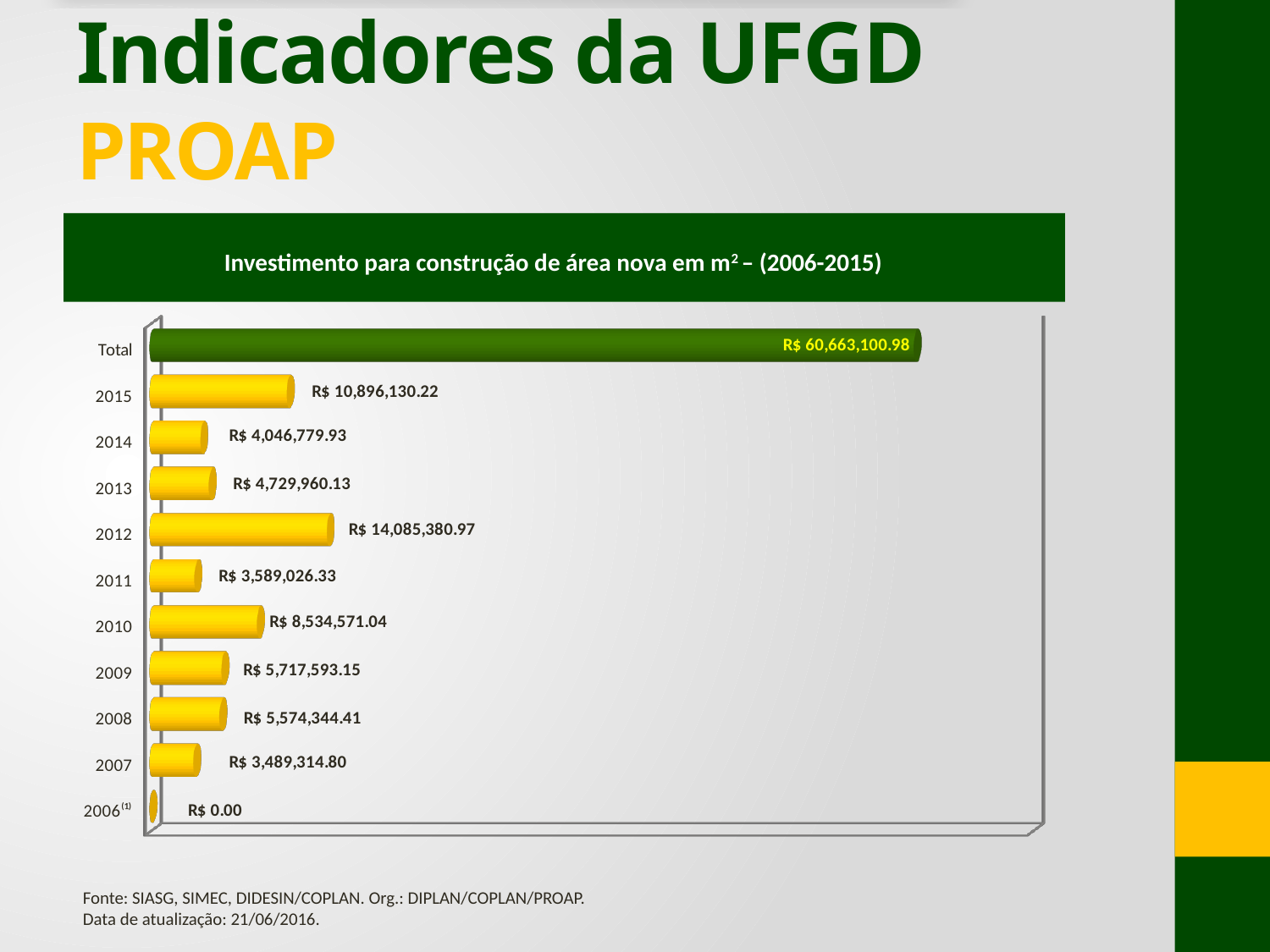
What is the title of the chart? Investimento para construção de área nova em m² – (2006-2015) Which is larger, the value for 2013 or the value for 2014? 2013 What is the difference between the values for 2015 and 2014? R$ 6,849,350.29 What is the difference between the values for 2012 and 2015? R$ 3,189,250.75 What is the value shown for 2007? R$ 3,489,314.80 What is the value shown for the Total bar? R$ 60,663,100.98 What is the value shown for 2010? R$ 8,534,571.04 What kind of chart is shown on the slide? Bar chart How many years (excluding the Total bar) are shown in the chart? 10 Which year has the lowest investment value? 2006 What is the value shown for 2012? R$ 14,085,380.97 Excluding the Total bar, which year has the highest investment value? 2012